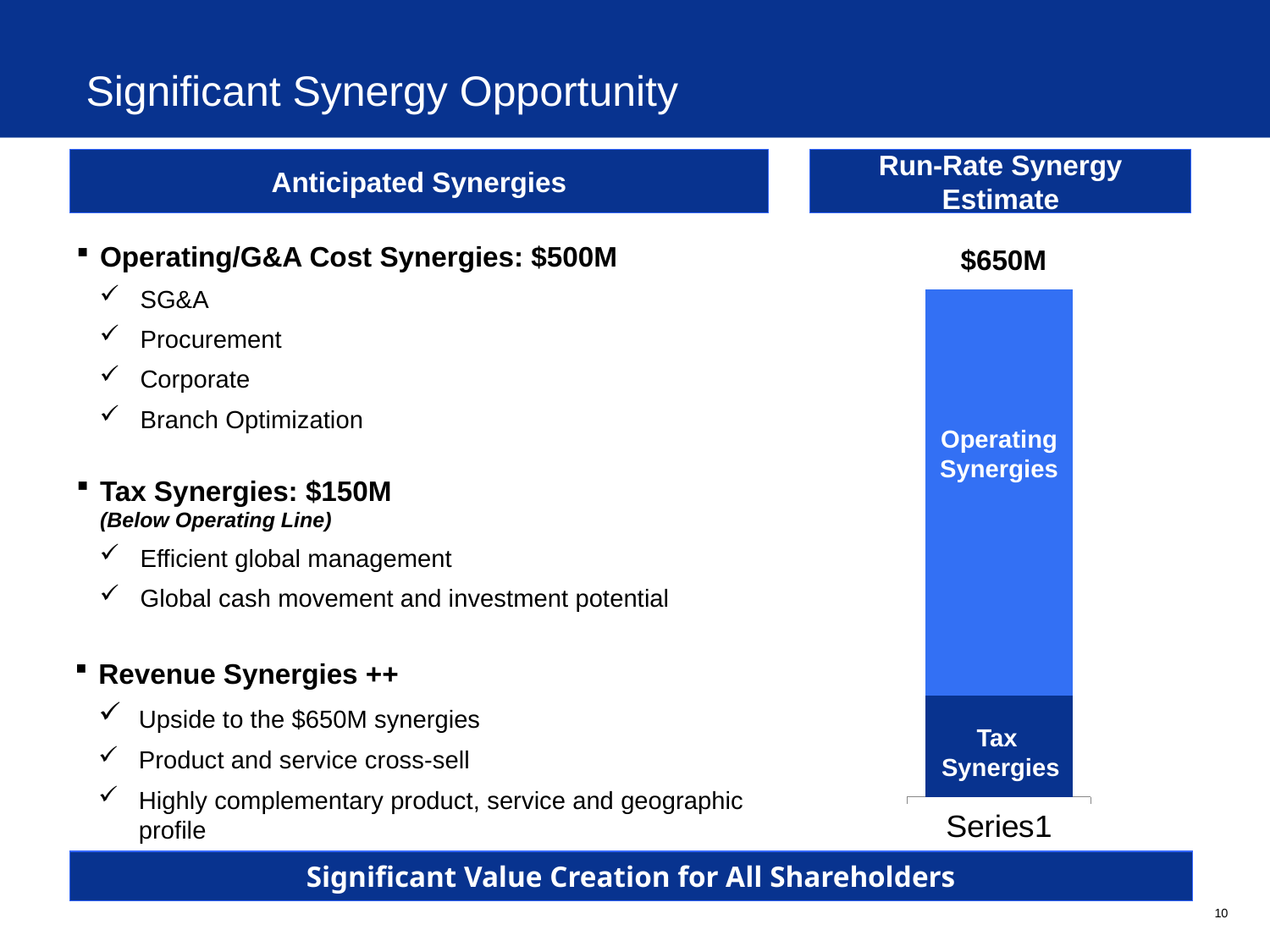
How many segments make up the stacked bar in the Run-Rate Synergy Estimate chart? 2 What kind of chart is shown under the 'Run-Rate Synergy Estimate' heading? Stacked bar chart What category label appears below the stacked bar? Series1 What is the value of the Tax Synergies segment, as stated on the slide? $150M Which segment of the stacked bar is the smallest? Tax Synergies Which segment of the stacked bar is shown in the darker blue colour? Tax Synergies Which segment of the stacked bar is larger, Operating Synergies or Tax Synergies? Operating Synergies Which segment sits at the bottom of the stacked bar? Tax Synergies What is the total run-rate synergy estimate shown above the stacked bar? $650M What is the difference between the Operating Synergies and Tax Synergies values stated on the slide? $350M What is the value of the Operating Synergies segment, as stated on the slide? $500M Which segment of the stacked bar is the largest? Operating Synergies